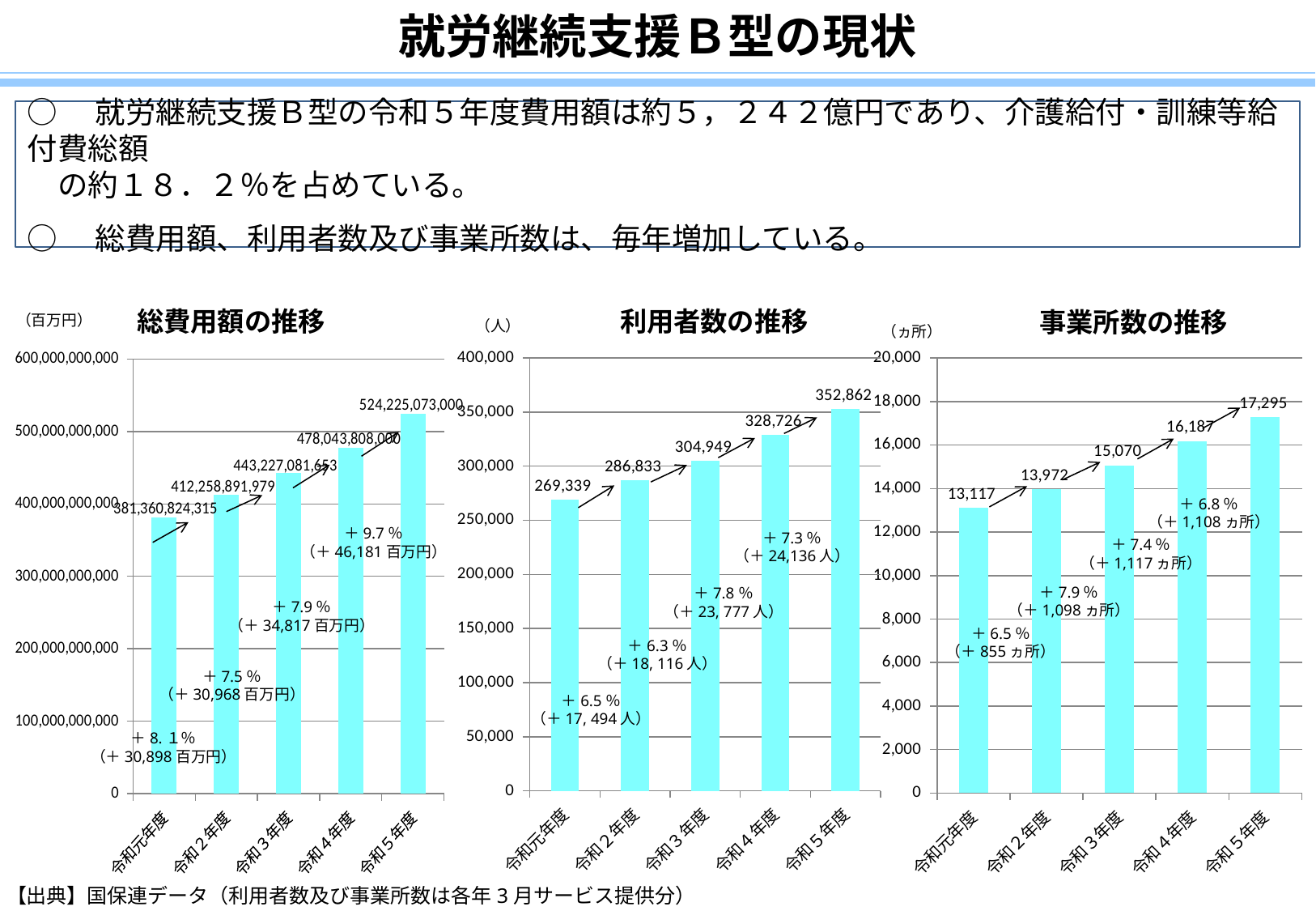
In the 利用者数の推移 chart, what is the value for 令和５年度? 352,862 In the 事業所数の推移 chart, which is larger, the value for 令和３年度 or 令和２年度? 令和３年度 In the 事業所数の推移 chart, which year has the lowest value? 令和元年度 In the 事業所数の推移 chart, what is the difference between the values for 令和５年度 and 令和４年度? 1,108 In the 総費用額の推移 chart, what is the value for 令和２年度? 412,258,891,979 What kind of chart is the 事業所数の推移 chart? bar chart In the 事業所数の推移 chart, what is the value for 令和元年度? 13,117 In the 利用者数の推移 chart, is the value for 令和元年度 greater or less than 250,000? greater In the 利用者数の推移 chart, what is the difference between the values for 令和３年度 and 令和２年度? 18,116 In the 利用者数の推移 chart, do the values rise or fall from 令和元年度 to 令和５年度? rise How many years are shown on the x axis of the 利用者数の推移 chart? 5 In the 総費用額の推移 chart, which year has the highest value? 令和５年度